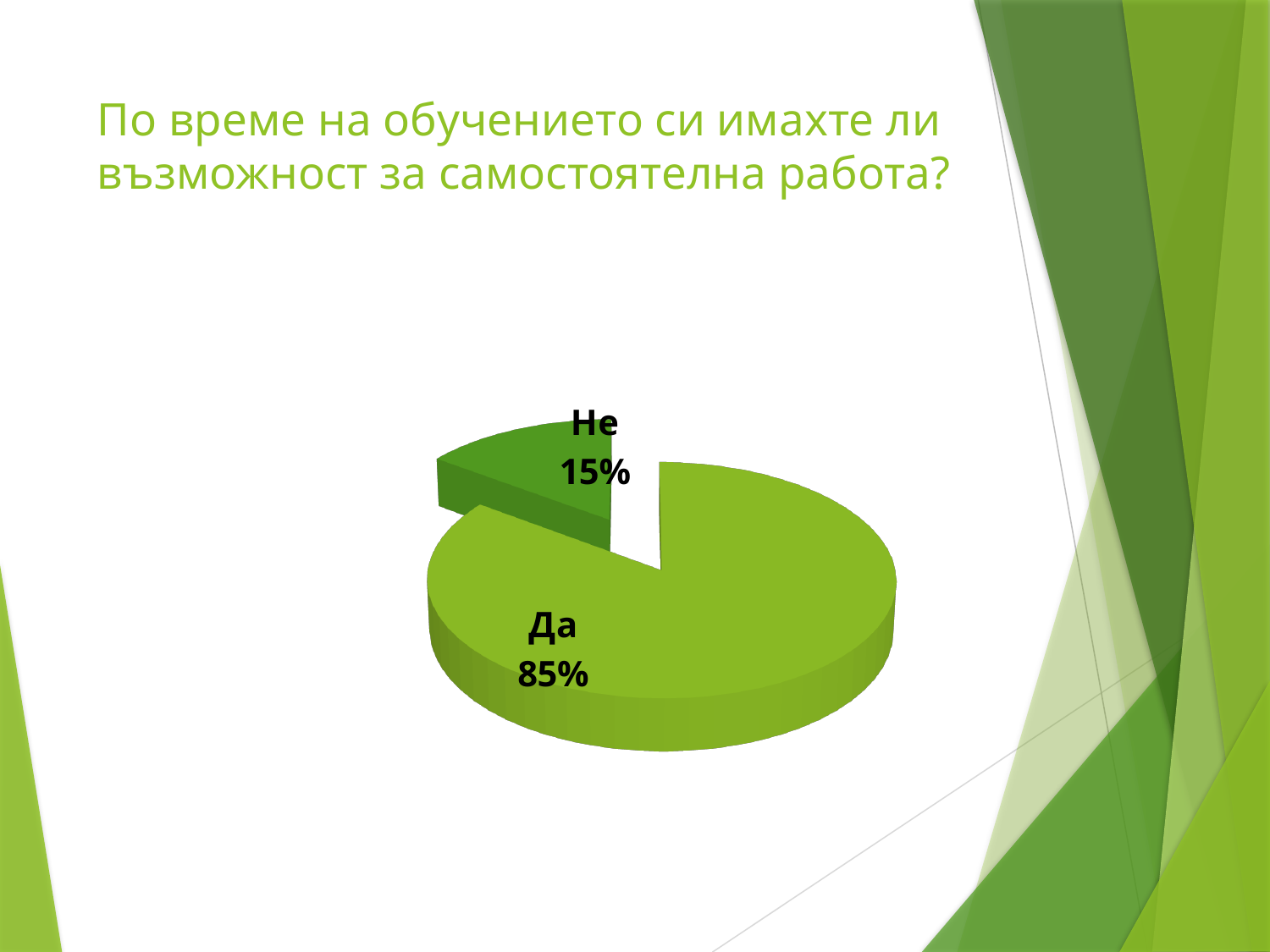
What percentage of respondents answered "Да"? 85% What share of the pie does the "Не" slice represent? 15% Which slice of the pie is the smallest? Не What is the difference in percentage points between the "Да" and "Не" slices? 70 Which is larger, the share for "Да" or the share for "Не"? Да Which slice of the pie is the largest? Да Which slice is pulled out (exploded) from the rest of the pie? Не What is the title of the slide containing the pie chart? По време на обучението си имахте ли възможност за самостоятелна работа? What kind of chart is shown on the slide? pie chart How many slices does the pie chart have? 2 What percentage of respondents answered "Не"? 15%